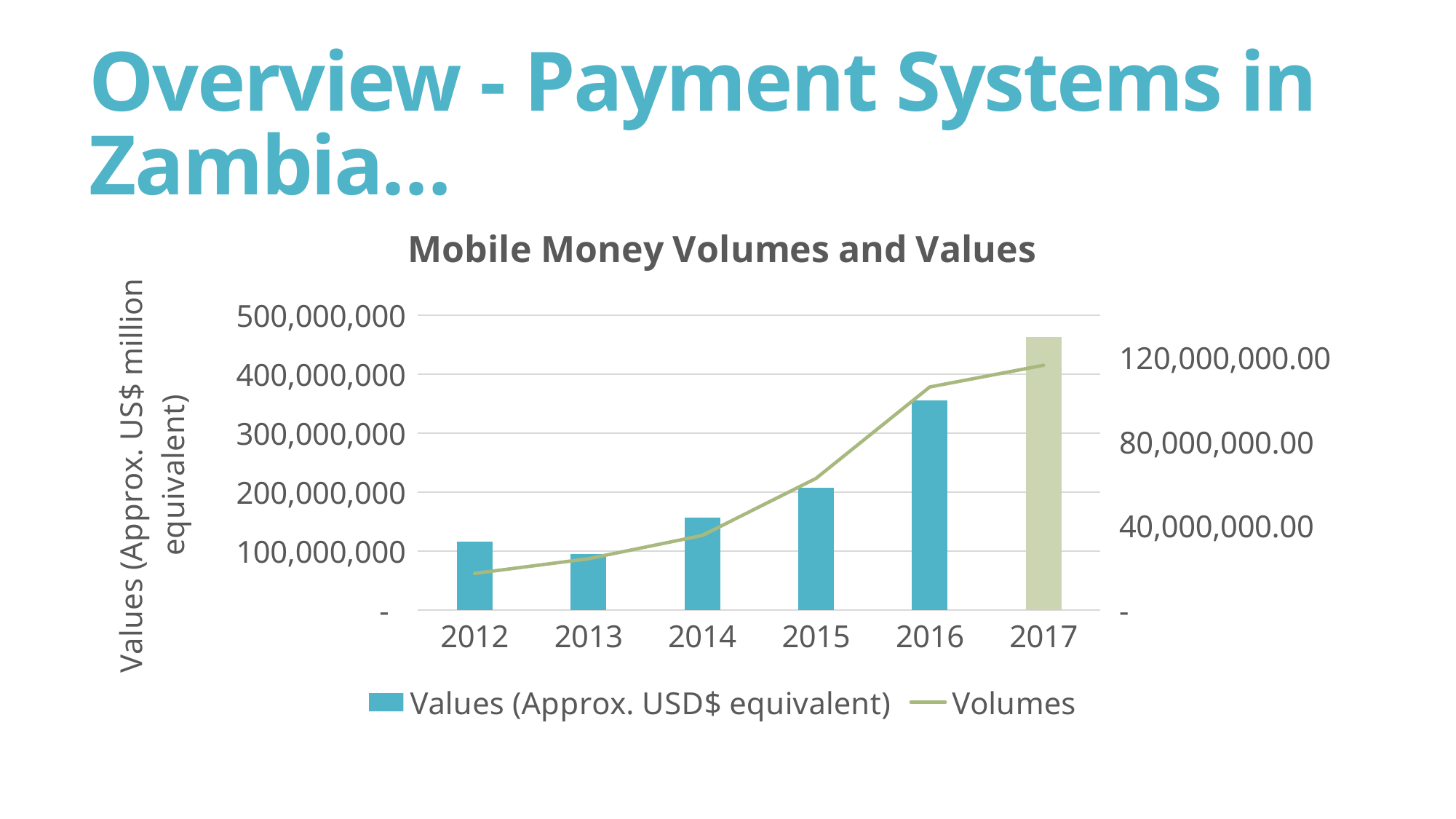
Which year has the highest bar for Values (Approx. USD$ equivalent)? 2017 How many series does the chart's legend list? 2 Which year has the lowest bar for Values (Approx. USD$ equivalent)? 2013 What is the title of the chart? Mobile Money Volumes and Values Which year has a larger Values bar, 2015 or 2016? 2016 Is the Values bar for 2014 greater or less than 200,000,000? less Which series is plotted as a line in the chart? Volumes Does the Volumes line generally rise or fall from 2012 to 2017? rise Is the Volumes value for 2016 greater or less than 80,000,000.00? greater Is the Volumes value for 2012 greater or less than 40,000,000.00? less How many years are shown on the x axis of the chart? 6